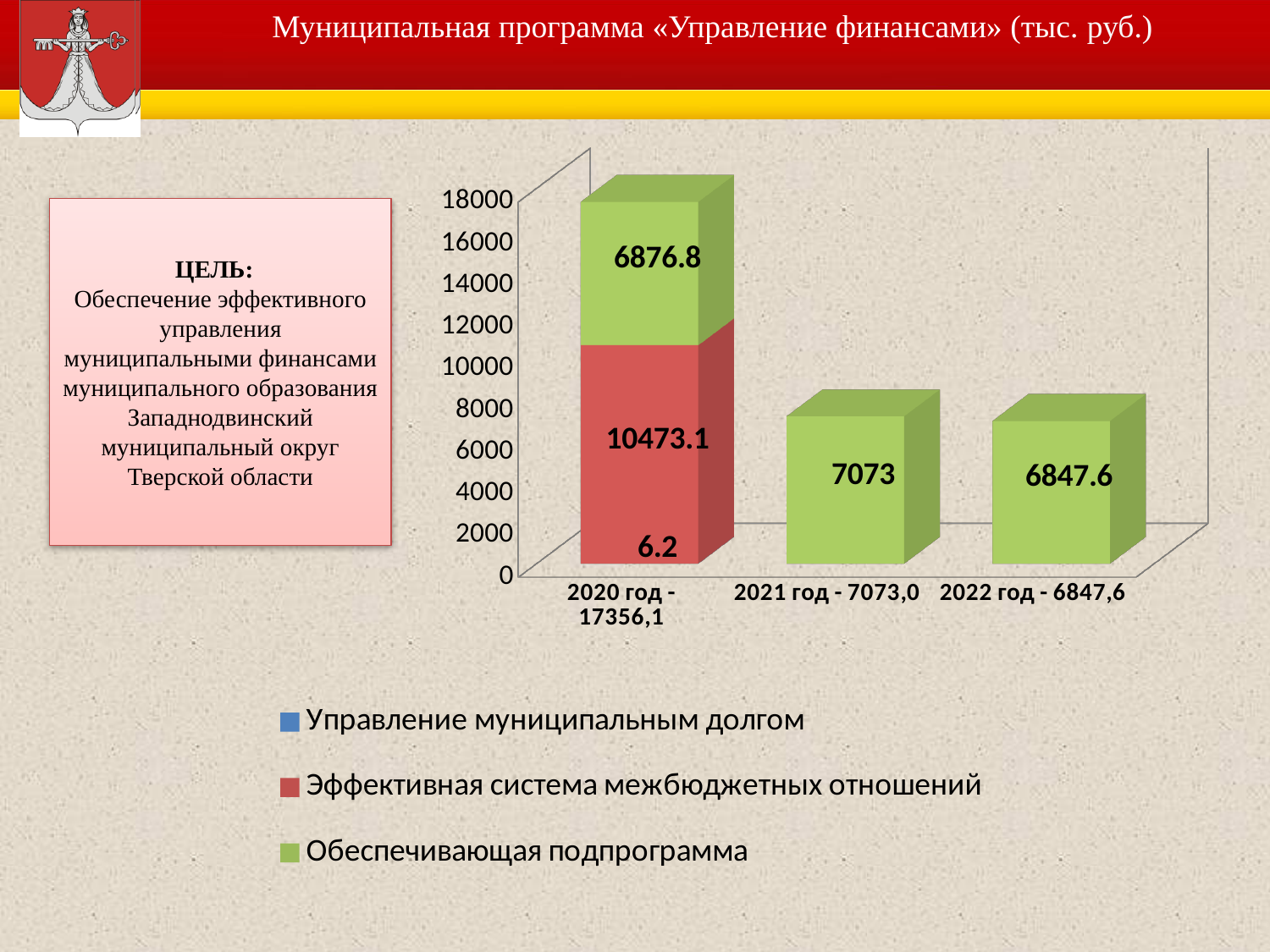
Do the total bar values rise or fall from 2020 год to 2022 год? Fall What is the value of Обеспечивающая подпрограмма for 2022 год? 6847.6 What kind of chart is shown on the slide? Stacked bar chart How many series does the chart legend list? 3 What is the value of Эффективная система межбюджетных отношений for 2020 год? 10473.1 What is the difference between the Обеспечивающая подпрограмма values for 2021 год and 2022 год? 225.4 What is the value of Управление муниципальным долгом for 2020 год? 6.2 How many year categories are shown on the x axis of the chart? 3 What is the total of the stacked bar for 2020 год? 17356.1 Which year has the highest total bar? 2020 год What is the value of Обеспечивающая подпрограмма for 2021 год? 7073 What is the value of Обеспечивающая подпрограмма for 2020 год? 6876.8